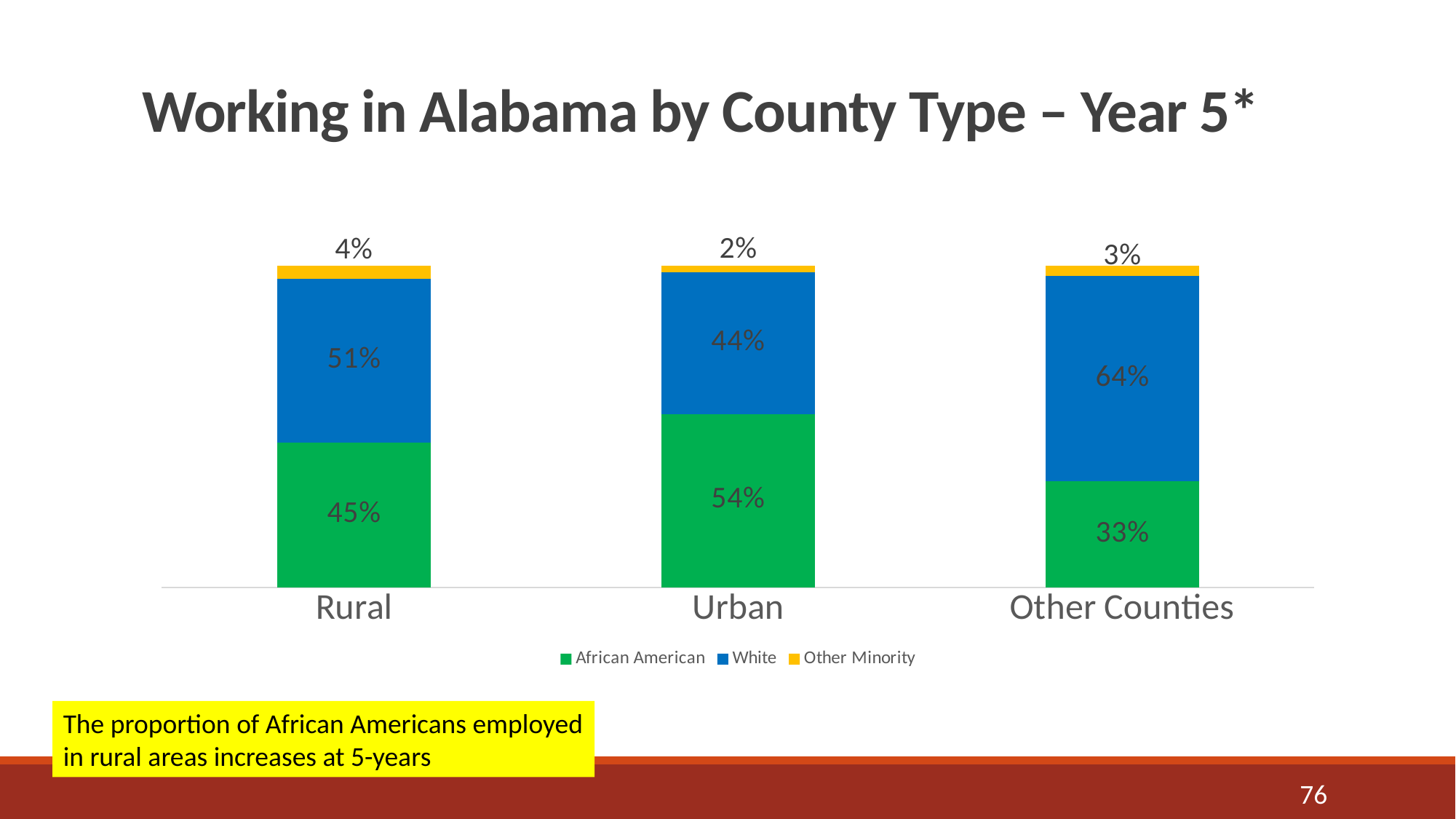
Which county type has the highest African American share? Urban What percentage of the Rural bar is African American? 45% What kind of chart is shown on the slide? Stacked bar chart What is the White share for Urban counties? 44% What is the Other Minority value for Other Counties? 3% Which county type has the lowest White share? Urban How many county types are shown on the x axis? 3 Is the African American share larger in Rural or Urban counties? Urban What is the African American value for Other Counties? 33% Which colour represents the Other Minority series? Yellow How many series does the legend list? 3 What is the difference between the White share in Other Counties and the White share in Rural counties? 13%